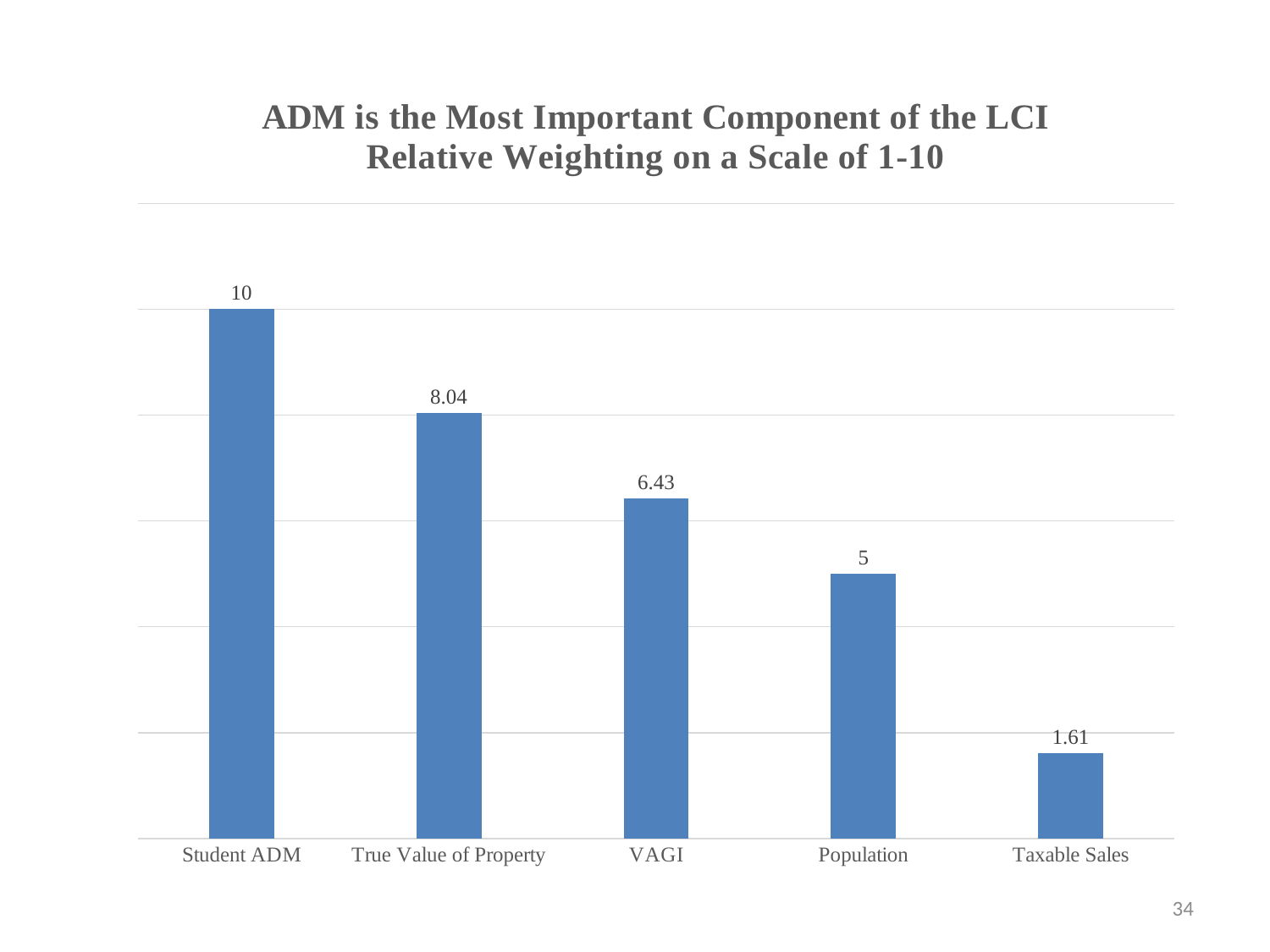
What is the relative weighting for Taxable Sales? 1.61 What is the difference between the weighting for Student ADM and the weighting for Population? 5 What is the relative weighting for True Value of Property? 8.04 How many components are shown on the chart? 5 Which has a larger relative weighting, VAGI or Population? VAGI What kind of chart is shown on the slide? Bar chart Do the values rise or fall from left to right across the chart? Fall Which component has the lowest relative weighting? Taxable Sales What is the difference between the weighting for True Value of Property and the weighting for VAGI? 1.61 Which component has the highest relative weighting? Student ADM What is the relative weighting for VAGI? 6.43 What is the relative weighting for Student ADM? 10